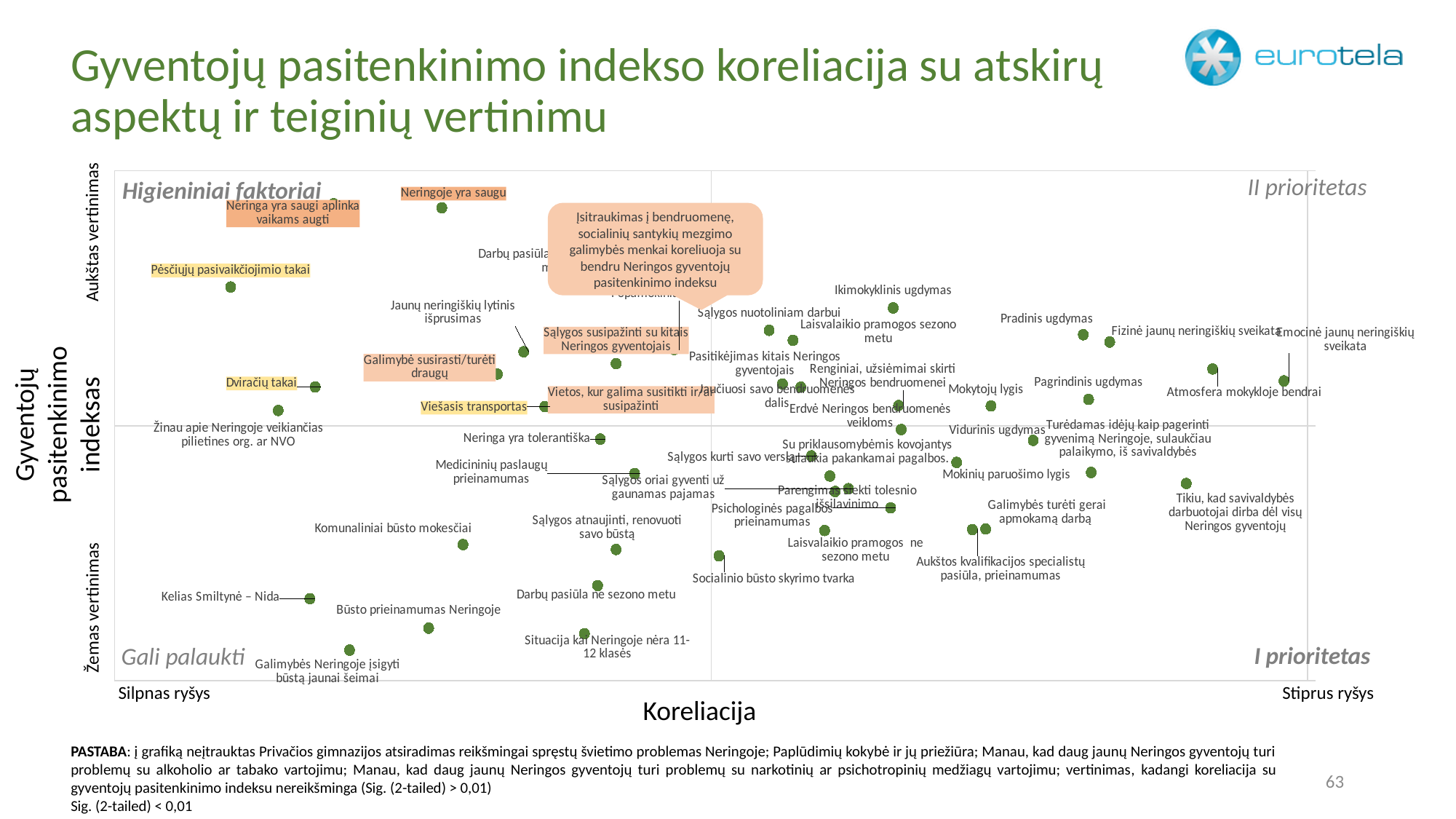
Which point is plotted lowest on the vertical axis (Gyventojų pasitenkinimo indeksas)? Galimybės Neringoje įsigyti būstą jaunai šeimai In which quadrant of the chart does the point 'Kelias Smiltynė – Nida' lie? Gali palaukti Which point is plotted highest on the vertical axis (Gyventojų pasitenkinimo indeksas)? Neringa yra saugi aplinka vaikams augti In which quadrant of the chart does the point 'Socialinio būsto skyrimo tvarka' lie? I prioritetas Which point is plotted furthest to the left on the Koreliacija axis? Pėsčiųjų pasivaikčiojimio takai Which point is plotted further to the right: 'Pradinis ugdymas' or 'Dviračių takai'? Pradinis ugdymas What is the label of the horizontal axis of the chart? Koreliacija What kind of chart is shown on the slide? Scatter plot What is the label of the vertical axis of the chart? Gyventojų pasitenkinimo indeksas Which point is plotted higher on the vertical axis: 'Neringoje yra saugu' or 'Kelias Smiltynė – Nida'? Neringoje yra saugu In which quadrant of the chart does the point 'Pradinis ugdymas' lie? II prioritetas Which point is plotted furthest to the right on the Koreliacija axis? Emocinė jaunų neringiškių sveikata